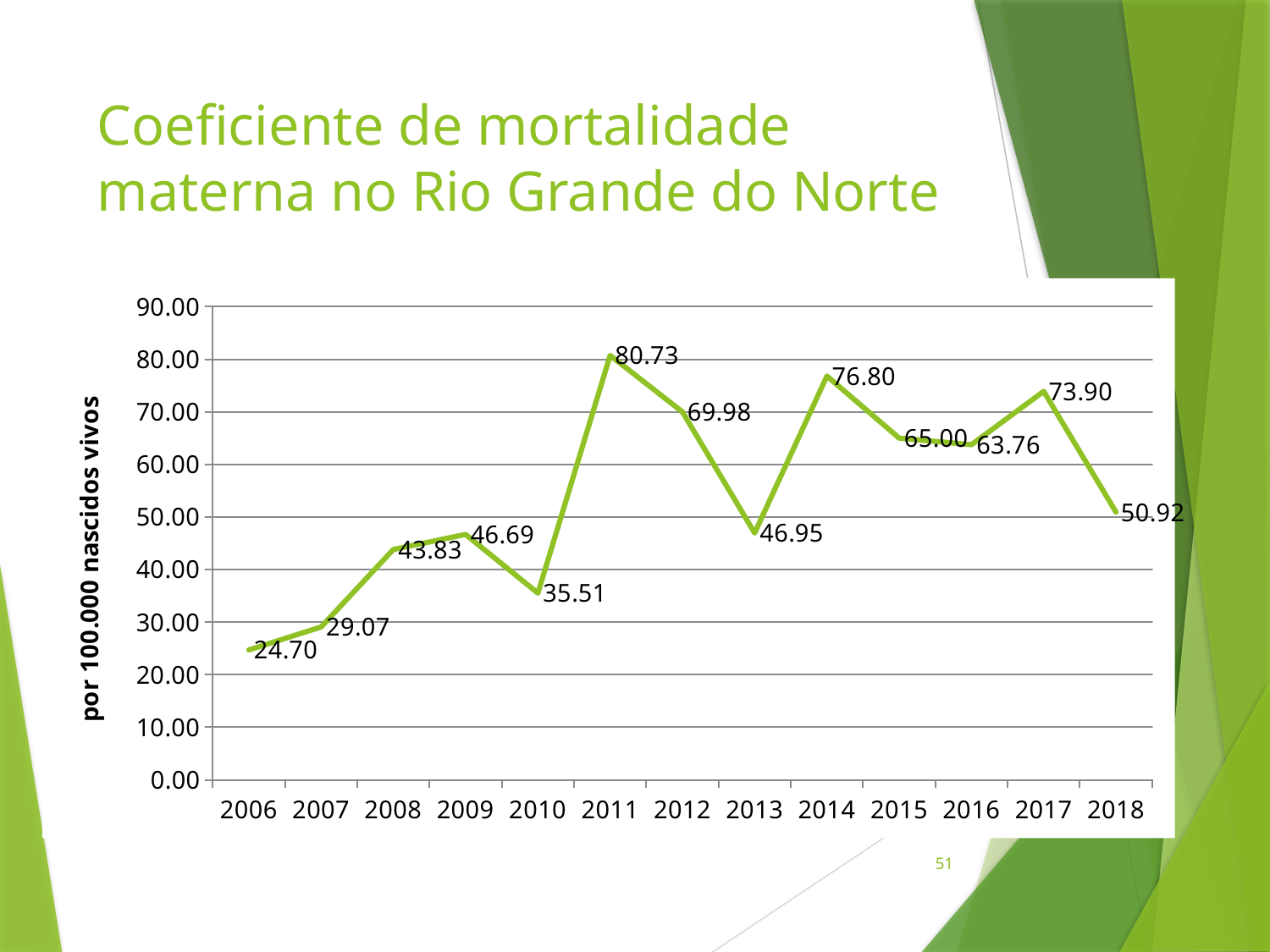
Which year has a larger value, 2012 or 2017? 2017 What is the value plotted for 2018? 50.92 What is the label of the vertical axis? por 100.000 nascidos vivos Does the value rise or fall from 2017 to 2018? fall How many years are plotted on the x axis? 13 What is the value plotted for 2006? 24.70 What is the difference between the values for 2014 and 2013? 29.85 Which year has the lowest value on the chart? 2006 What is the maternal mortality coefficient for 2011? 80.73 Which year has the highest value on the chart? 2011 Is the value for 2010 greater or less than 40.00? less What kind of chart is shown on the slide? line chart